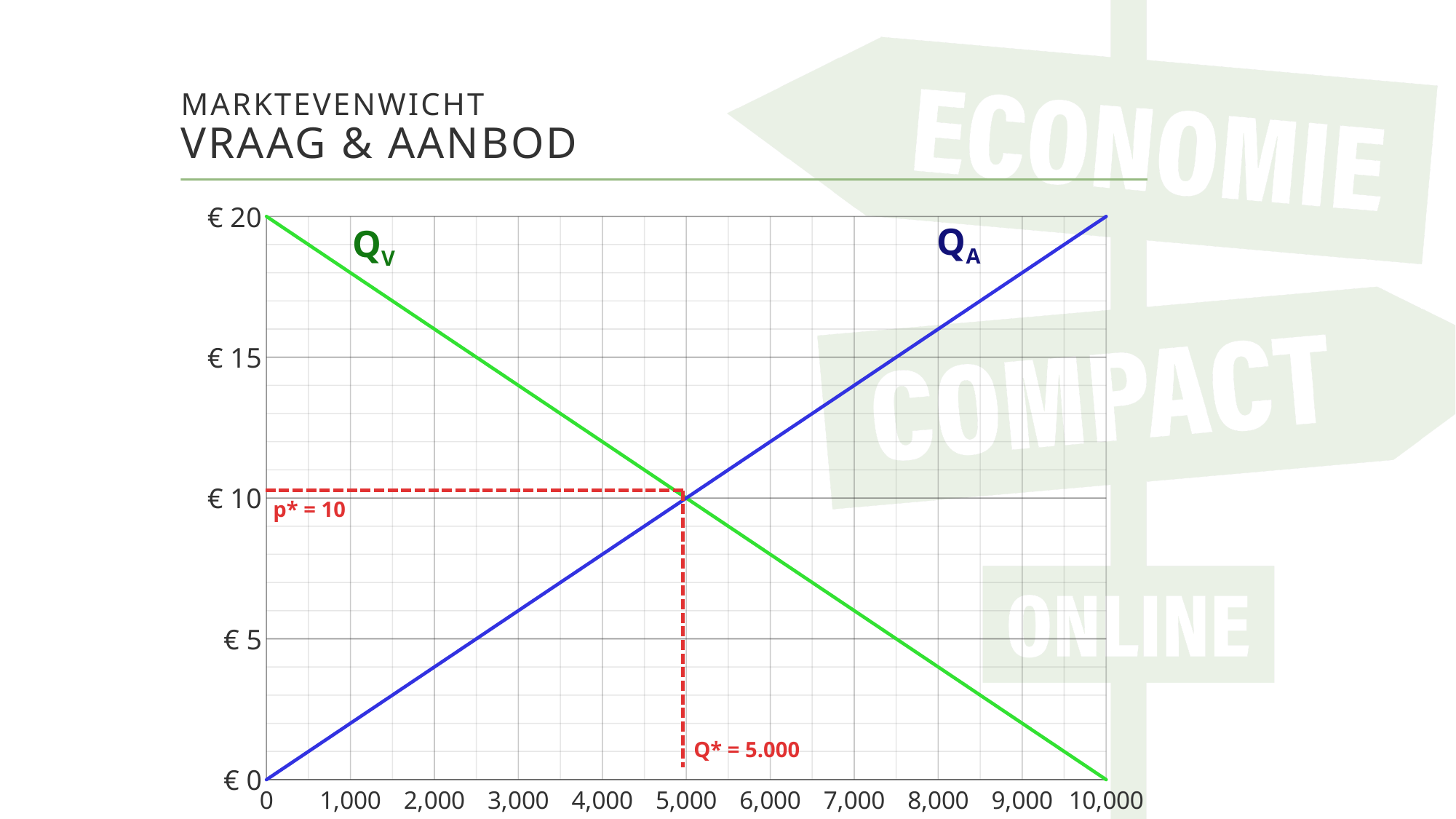
Does the Q_V line rise or fall as quantity increases along the x axis? fall Does the Q_A line rise or fall as quantity increases along the x axis? rise What is the price on the Q_V line at a quantity of 0? € 20 What is the price on the Q_A line at a quantity of 10,000? € 20 How many lines are plotted on the chart? 2 What type of chart is shown on the slide? line chart What is the equilibrium quantity Q* marked on the chart? 5.000 What is the price on the Q_V line at a quantity of 10,000? € 0 What colour is the Q_A line? blue At a quantity of 2,000, which line has the higher price, Q_V or Q_A? Q_V What is the equilibrium price p* marked on the chart? 10 At a quantity of 8,000, is the price on the Q_A line greater or less than € 15? greater